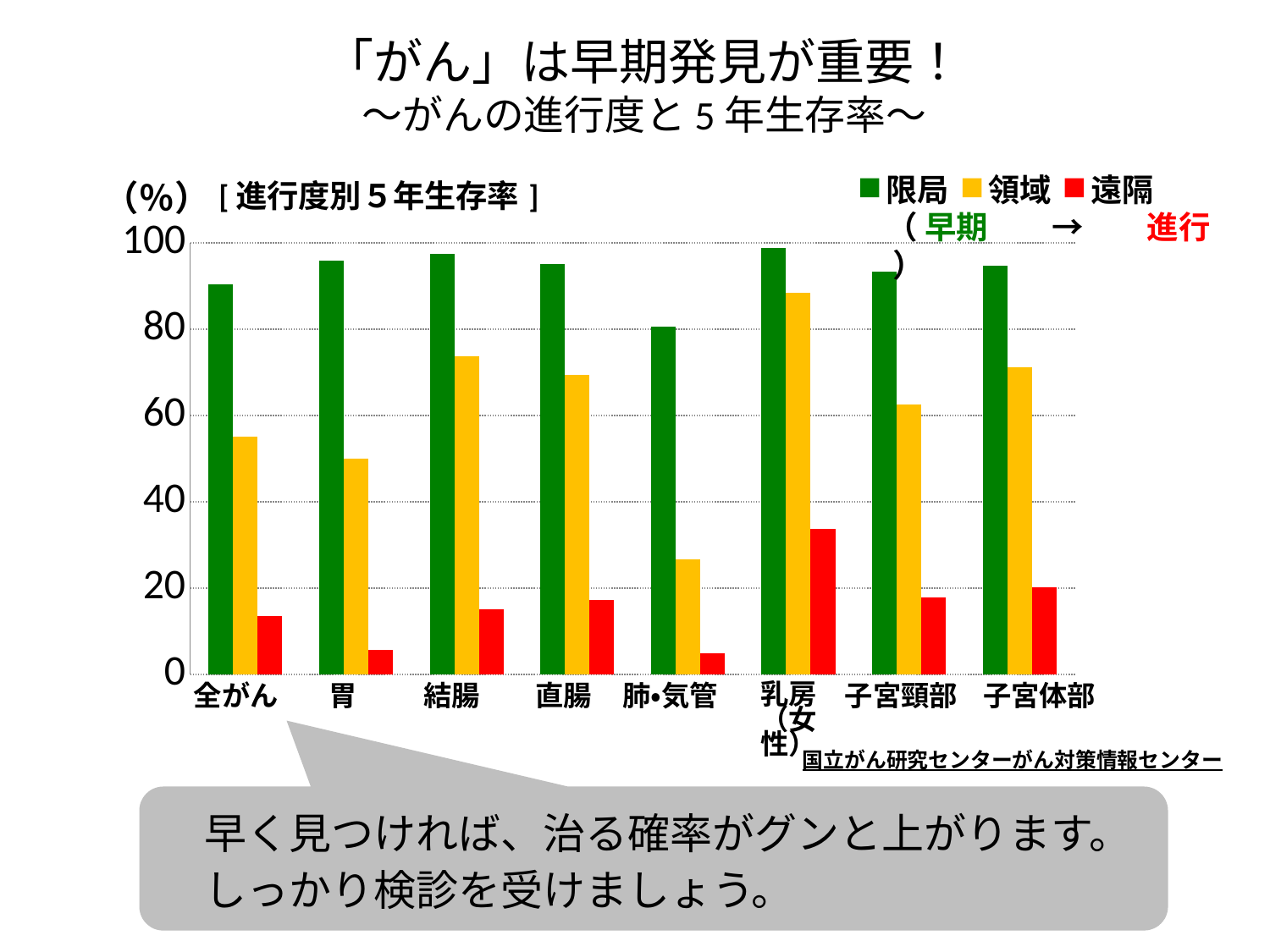
How many cancer categories are shown on the x axis? 8 How many series does the legend list? 3 Which category has the highest 遠隔 value? 乳房（女性） Which category has the highest 領域 value? 乳房（女性） Which is larger, the 領域 value for 乳房（女性） or for 子宮頸部? 乳房（女性） Which category has the lowest 限局 value? 肺・気管 Is the 領域 value for 肺・気管 greater or less than 40? less What kind of chart is shown on the slide? bar chart Is the 領域 value for 結腸 greater or less than 60? greater What are the three series listed in the legend? 限局, 領域, 遠隔 Which category has the lowest 領域 value? 肺・気管 Is the 遠隔 value for 乳房（女性） greater or less than 20? greater